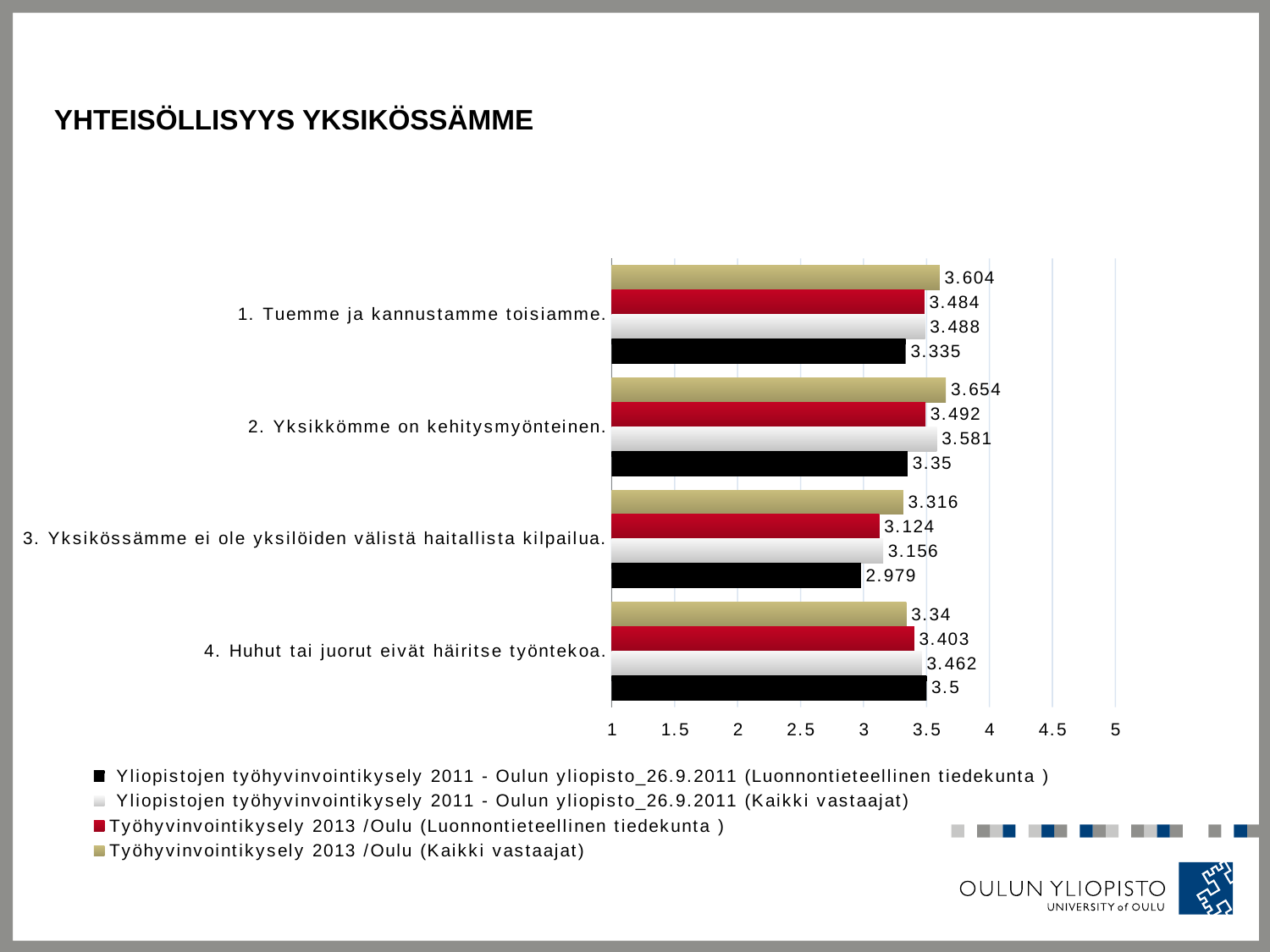
What type of chart is shown on the slide? bar chart What is the value for "4. Huhut tai juorut eivät häiritse työntekoa." in the series "Työhyvinvointikysely 2013 /Oulu (Luonnontieteellinen tiedekunta )"? 3.403 For "4. Huhut tai juorut eivät häiritse työntekoa.", which is larger: the "Yliopistojen työhyvinvointikysely 2011 - Oulun yliopisto_26.9.2011 (Luonnontieteellinen tiedekunta )" value or the "Työhyvinvointikysely 2013 /Oulu (Kaikki vastaajat)" value? Yliopistojen työhyvinvointikysely 2011 - Oulun yliopisto_26.9.2011 (Luonnontieteellinen tiedekunta ) What is the title of the slide containing the chart? YHTEISÖLLISYYS YKSIKÖSSÄMME How many series does the legend list? 4 Is the value for "3. Yksikössämme ei ole yksilöiden välistä haitallista kilpailua." in the series "Työhyvinvointikysely 2013 /Oulu (Luonnontieteellinen tiedekunta )" greater or less than 3.5? less Which category has the lowest value in the series "Yliopistojen työhyvinvointikysely 2011 - Oulun yliopisto_26.9.2011 (Kaikki vastaajat)"? 3. Yksikössämme ei ole yksilöiden välistä haitallista kilpailua. What is the difference between the "Työhyvinvointikysely 2013 /Oulu (Kaikki vastaajat)" value and the "Yliopistojen työhyvinvointikysely 2011 - Oulun yliopisto_26.9.2011 (Luonnontieteellinen tiedekunta )" value for "2. Yksikkömme on kehitysmyönteinen."? 0.304 Which category has the highest value in the series "Työhyvinvointikysely 2013 /Oulu (Kaikki vastaajat)"? 2. Yksikkömme on kehitysmyönteinen. What is the value for "1. Tuemme ja kannustamme toisiamme." in the series "Työhyvinvointikysely 2013 /Oulu (Kaikki vastaajat)"? 3.604 What is the value for "3. Yksikössämme ei ole yksilöiden välistä haitallista kilpailua." in the series "Yliopistojen työhyvinvointikysely 2011 - Oulun yliopisto_26.9.2011 (Luonnontieteellinen tiedekunta )"? 2.979 How many categories (statements) are plotted on the chart? 4